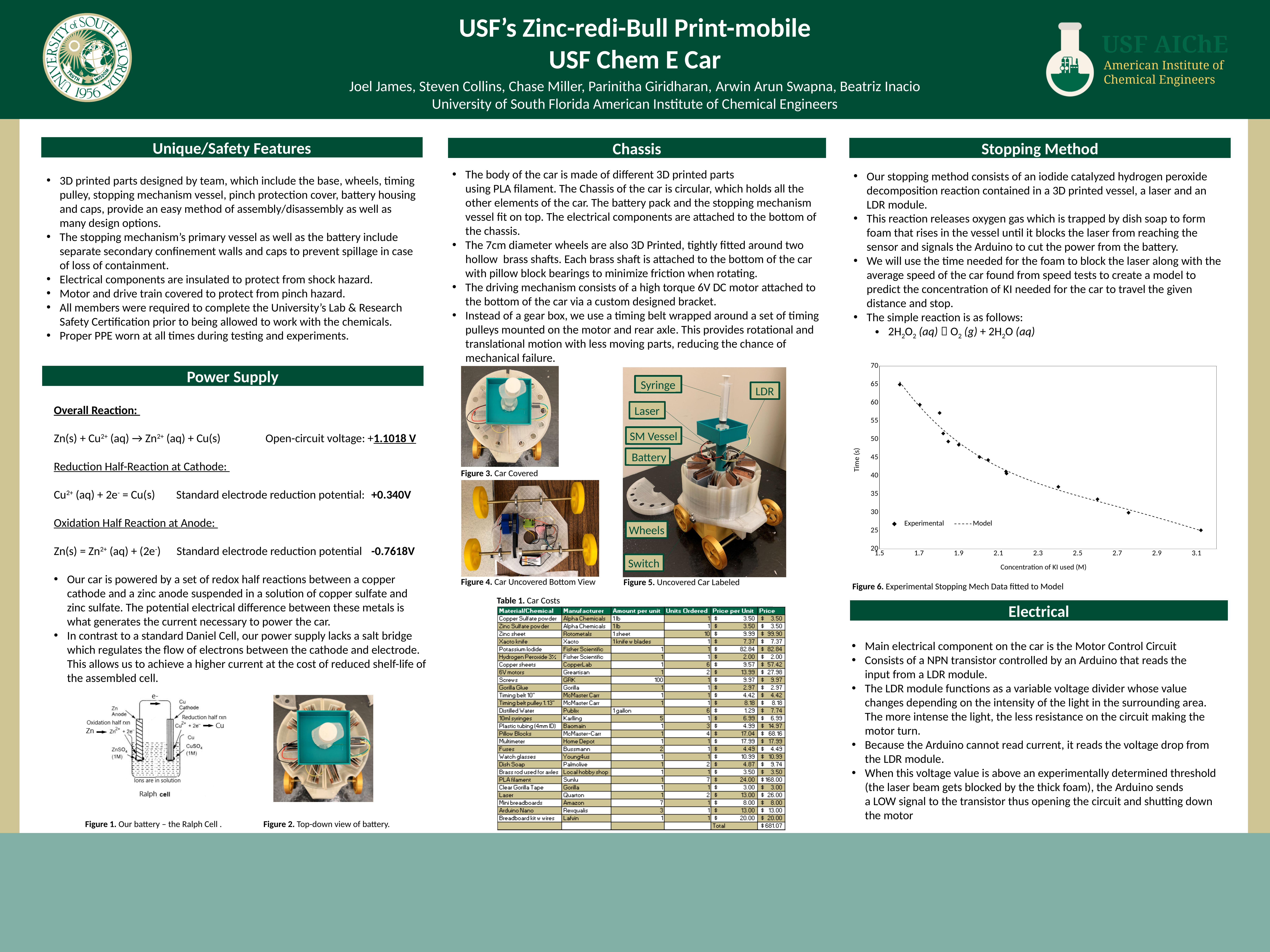
In Figure 6, is the experimental time at the lowest KI concentration (about 1.6 M) greater or less than 60 s? greater What kind of chart is Figure 6 (Experimental Stopping Mech Data fitted to Model)? scatter chart What is the label of the x axis in Figure 6? Concentration of KI used (M) In Figure 6, does the time rise or fall as the concentration of KI increases? fall In Figure 6, is the experimental time at a KI concentration of about 1.9 M greater or less than 45 s? greater In Figure 6, is the experimental time at the highest KI concentration (about 3.1 M) greater or less than 30 s? less How many series does the legend of Figure 6 list? 2 In Figure 6, which legend series is drawn as a dashed line? Model In Figure 6, which has the longer time: the point at about 1.7 M or the point at about 2.8 M? the point at about 1.7 M